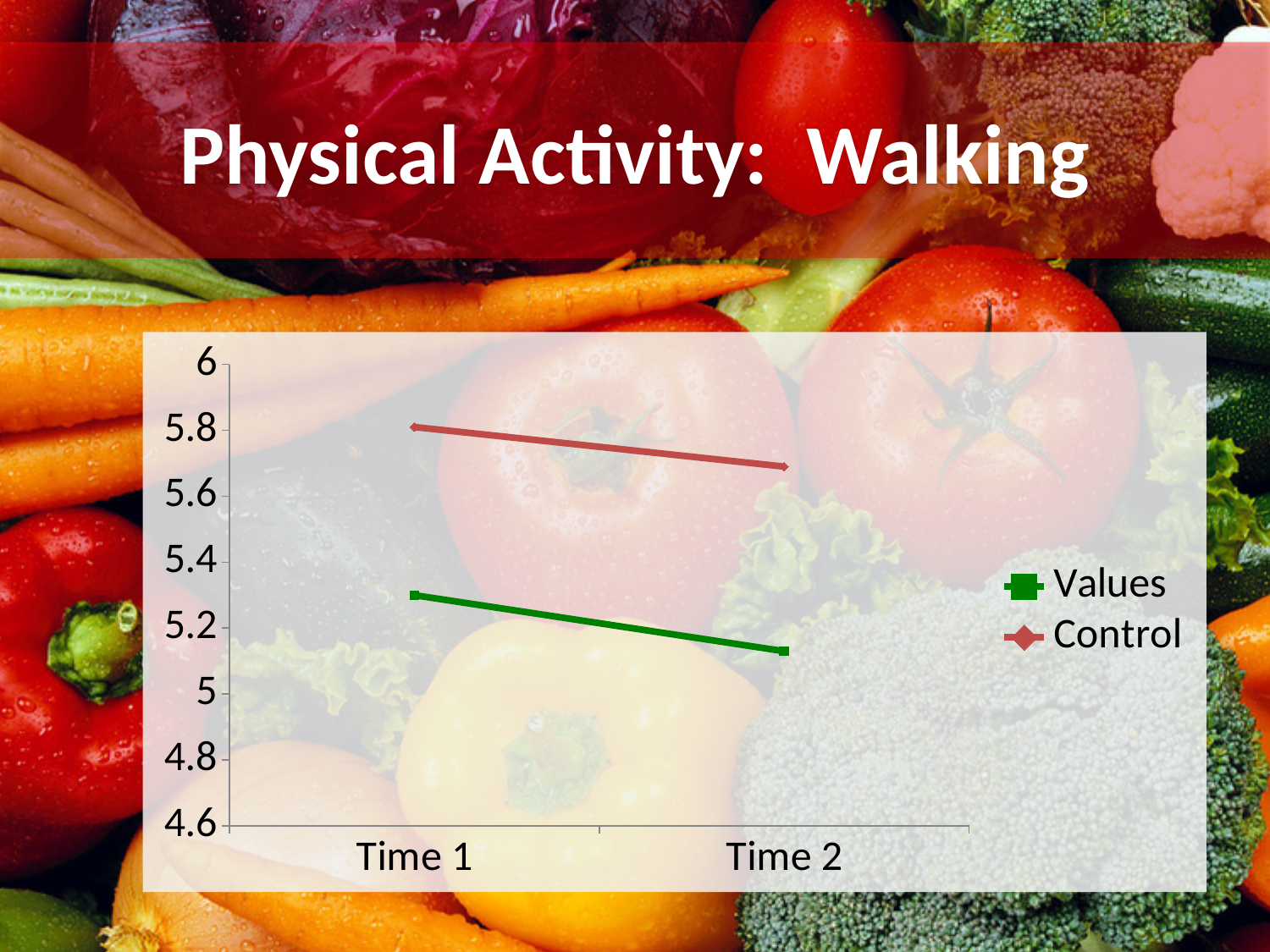
Which series is higher at Time 1, Values or Control? Control What is the title of the slide containing the chart? Physical Activity: Walking Is the value for Control at Time 1 greater or less than 5.6? greater Does the Values line rise or fall from Time 1 to Time 2? fall Is the value for Values at Time 2 greater or less than 5.2? less Is the value for Values at Time 1 greater or less than 5.4? less How many series does the legend list? 2 How many time points are shown on the x axis? 2 Does the Control line rise or fall from Time 1 to Time 2? fall Which series is lower at Time 2, Values or Control? Values What colour is the Control line in the chart? red What kind of chart is shown on the slide? line chart